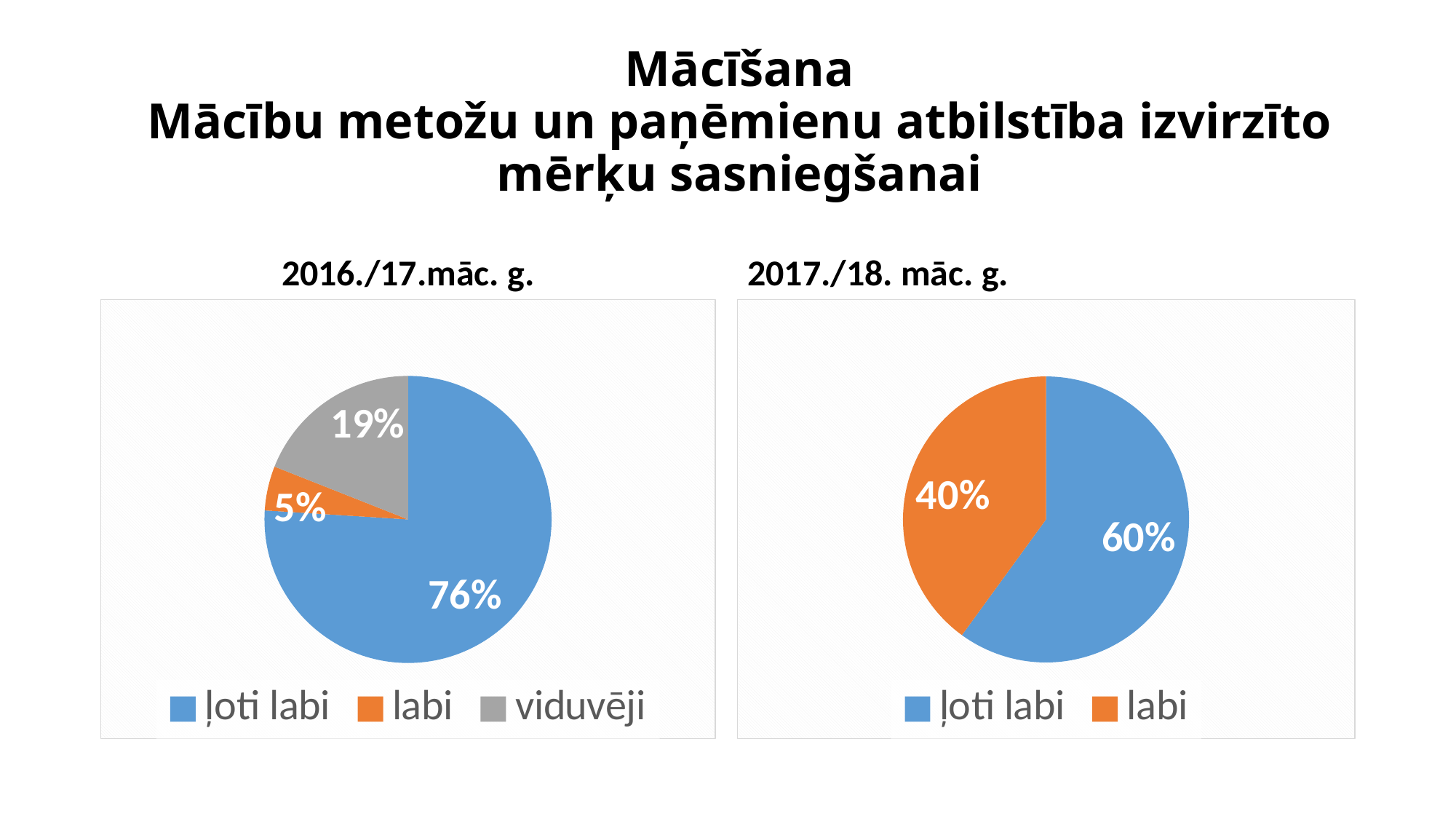
In the 2017./18. māc. g. chart, what share does the 'ļoti labi' slice have? 60% In the 2016./17.māc. g. chart, what is the difference between the 'ļoti labi' and 'viduvēji' shares? 57% In the 2017./18. māc. g. chart, what is the difference between the 'ļoti labi' and 'labi' shares? 20% In the 2016./17.māc. g. chart, what share does the 'ļoti labi' slice have? 76% In the 2016./17.māc. g. chart, what share does the 'viduvēji' slice have? 19% How many categories does the legend of the 2017./18. māc. g. chart list? 2 How many categories does the legend of the 2016./17.māc. g. chart list? 3 In the 2016./17.māc. g. chart, which category has the smallest slice? labi What type of chart is the 2017./18. māc. g. chart? Pie chart In the 2016./17.māc. g. chart, what share does the 'labi' slice have? 5% In the 2017./18. māc. g. chart, which category has the largest slice? ļoti labi In the 2017./18. māc. g. chart, what share does the 'labi' slice have? 40%